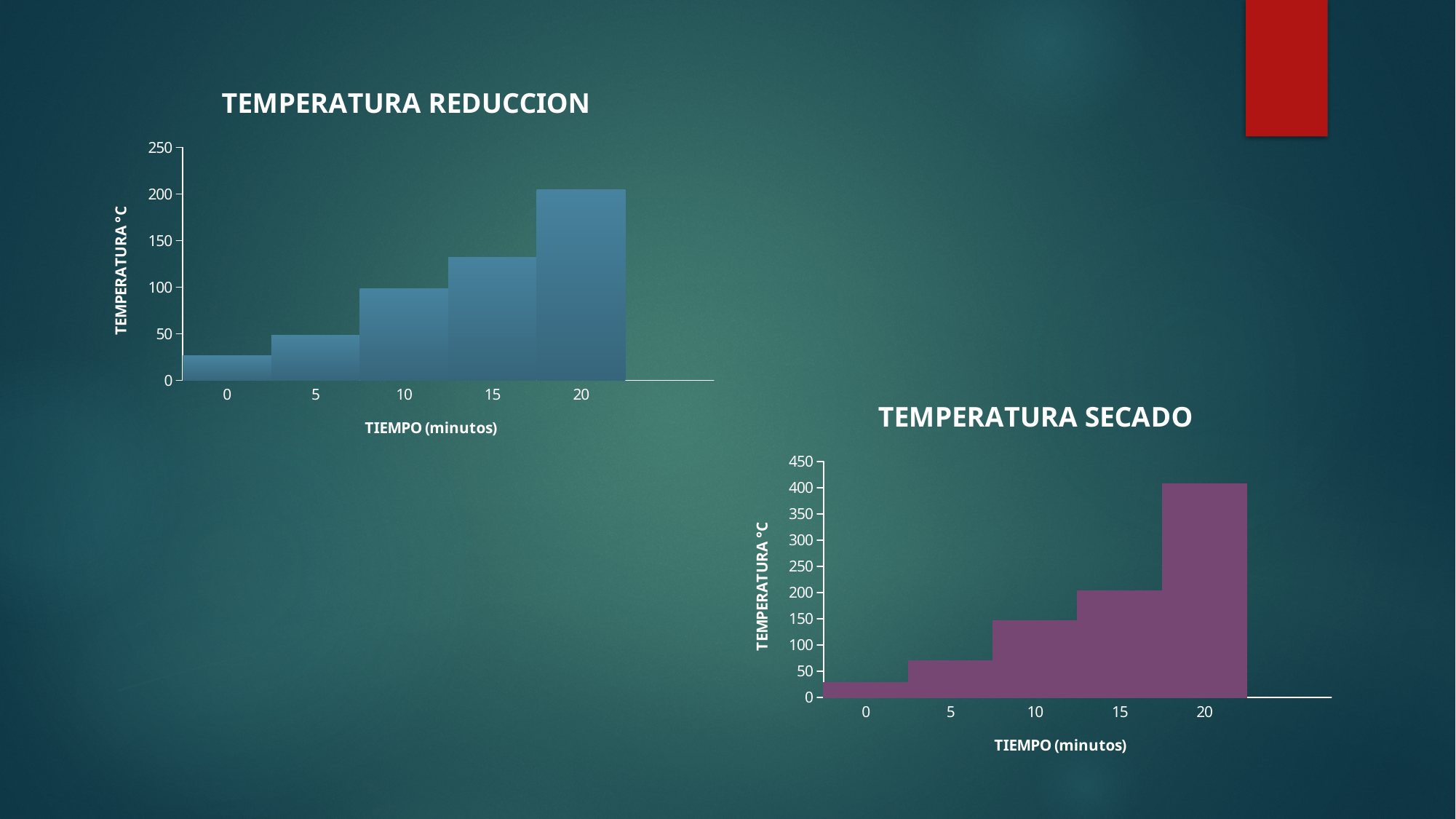
In the TEMPERATURA SECADO chart, which time (minutos) has the lowest temperature? 0 In the TEMPERATURA REDUCCION chart, how many bars are plotted? 5 In the TEMPERATURA SECADO chart, is the value at 5 minutes greater or less than 100? less What is the label of the y axis on the TEMPERATURA REDUCCION chart? TEMPERATURA °C In the TEMPERATURA SECADO chart, do the temperature values rise or fall as time increases along the x axis? rise In the TEMPERATURA REDUCCION chart, what kind of chart is shown? bar chart In the TEMPERATURA REDUCCION chart, which time (minutos) has the highest temperature? 20 In the TEMPERATURA SECADO chart, what kind of chart is shown? bar chart In the TEMPERATURA SECADO chart, how many time categories are shown on the x axis? 5